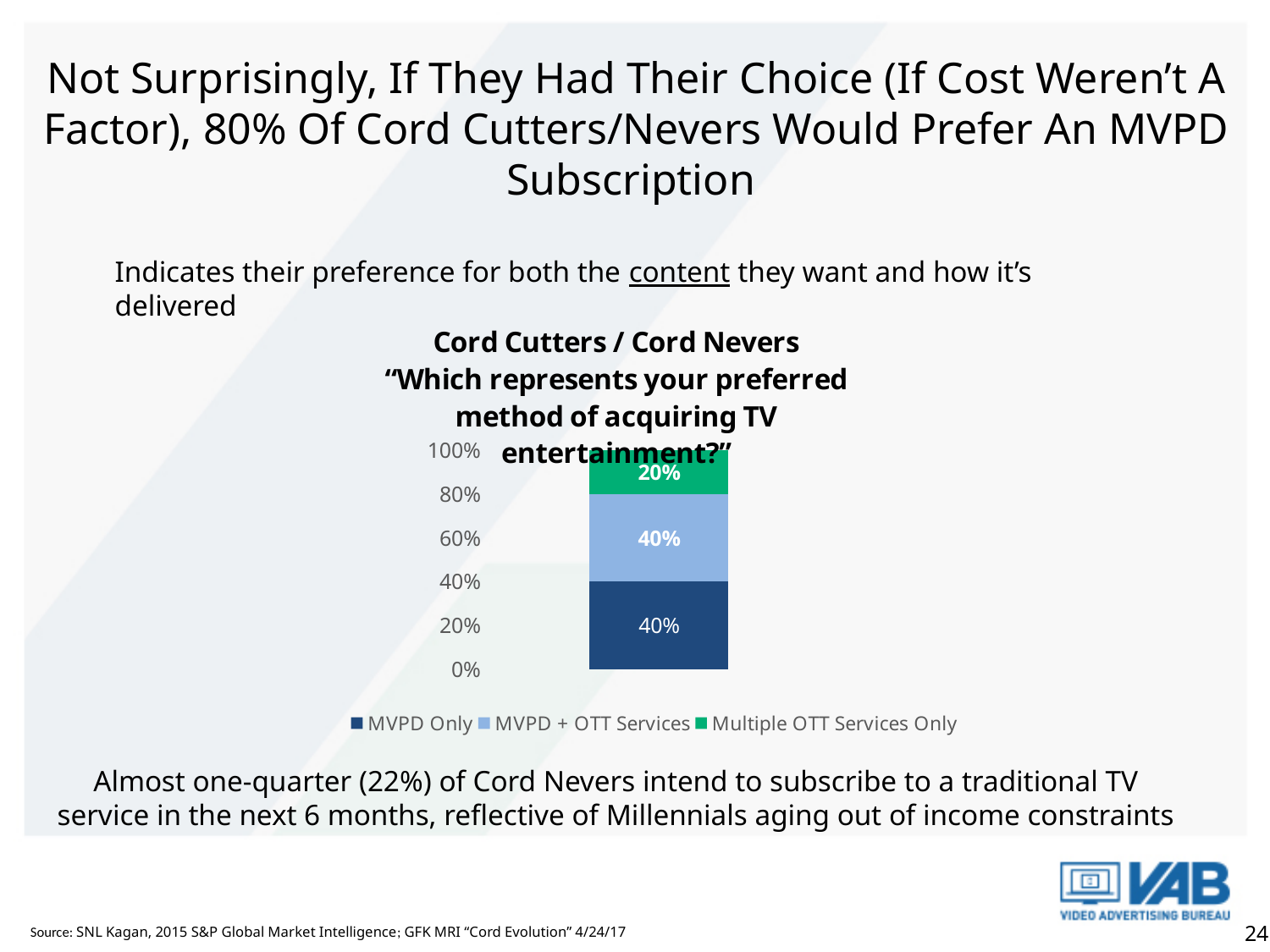
Is the value for Multiple OTT Services Only greater or less than 40%? less What percentage of Cord Cutters / Cord Nevers prefer MVPD + OTT Services? 40% What kind of chart is shown on the slide? Stacked bar chart Which is larger, the share for MVPD + OTT Services or the share for Multiple OTT Services Only? MVPD + OTT Services What is the combined share of the two segments that include an MVPD subscription (MVPD Only and MVPD + OTT Services)? 80% What percentage of Cord Cutters / Cord Nevers prefer MVPD Only? 40% Which legend entry is shown in green? Multiple OTT Services Only How many series does the legend list? 3 What percentage of Cord Cutters / Cord Nevers prefer Multiple OTT Services Only? 20% What is the difference between the MVPD Only share and the Multiple OTT Services Only share? 20% What is the total of the three segments in the stacked bar? 100% Which preferred method has the smallest share of the stacked bar? Multiple OTT Services Only